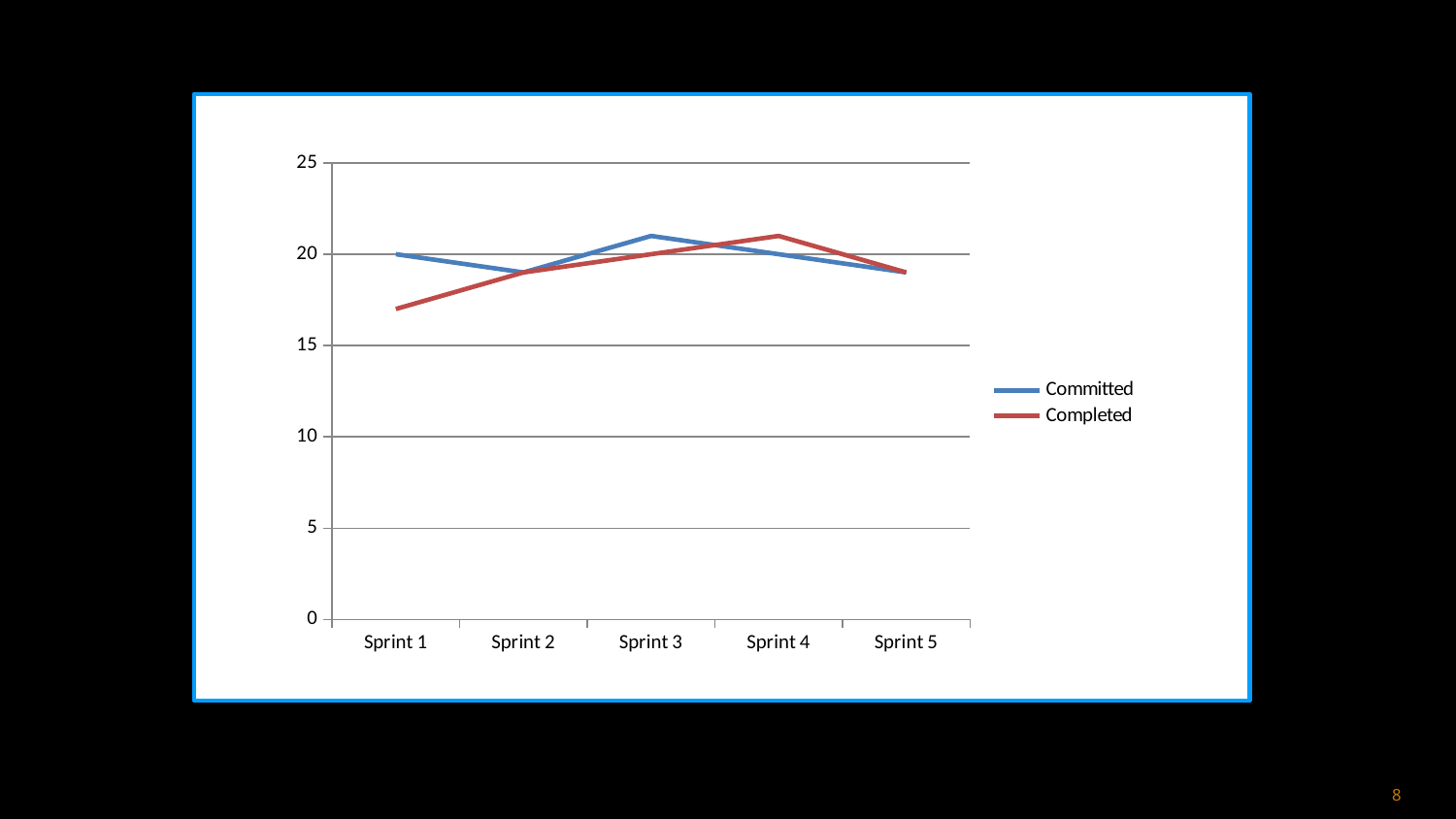
Is the Completed value for Sprint 1 greater or less than 20? less What is the Committed value for Sprint 1? 20 In which sprint is the Completed value lowest? Sprint 1 In which sprint is the Completed value highest? Sprint 4 In which sprint is the Committed value highest? Sprint 3 In Sprint 1, which series has the larger value, Committed or Completed? Committed Is the Completed value for Sprint 4 greater or less than 20? greater Is the Committed value for Sprint 5 greater or less than 20? less What kind of chart is shown on the slide? line chart How many sprints are shown on the x axis? 5 How many series does the legend list? 2